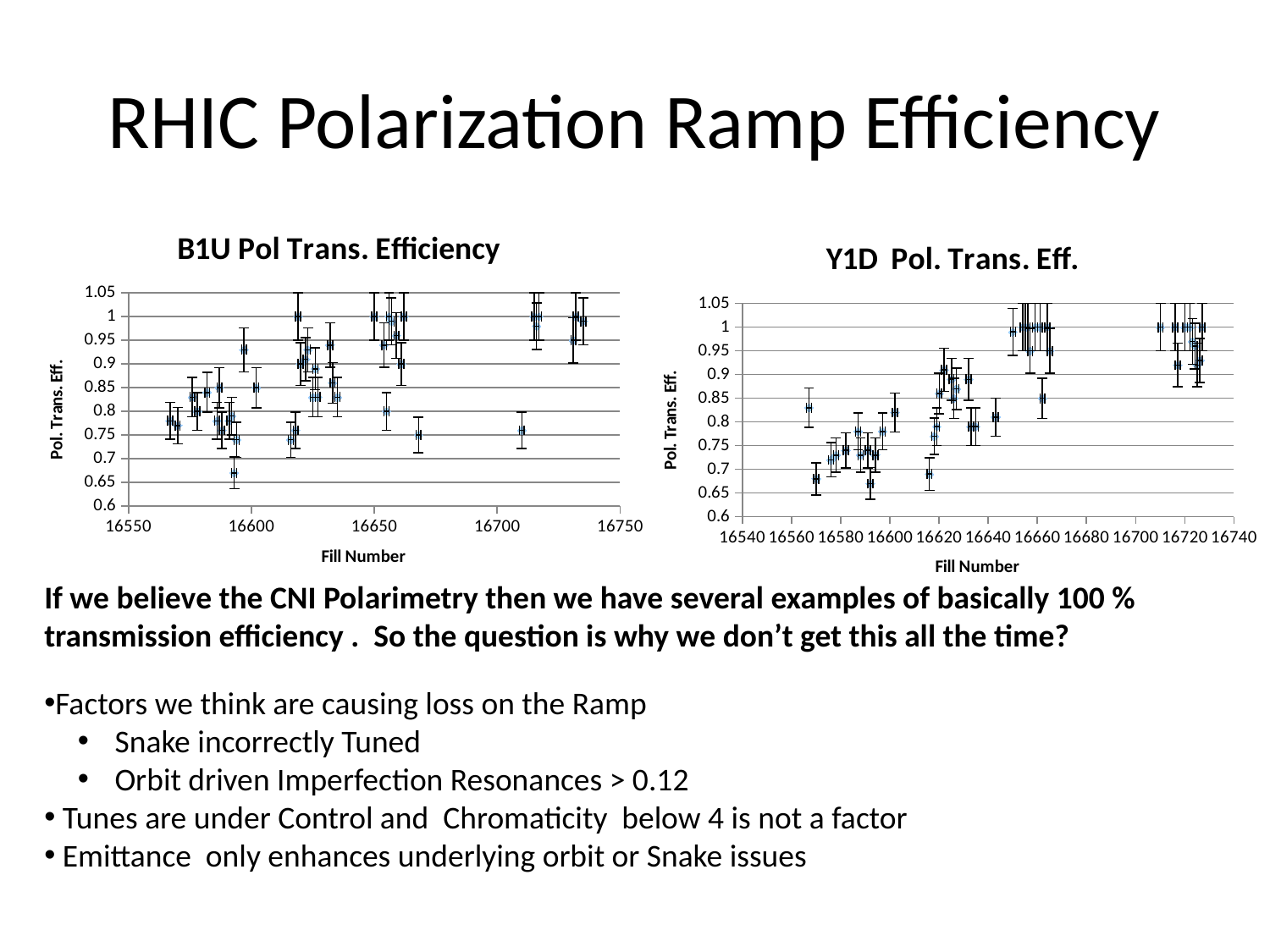
What kind of chart is the Y1D Pol. Trans. Eff. chart? scatter chart In the B1U Pol Trans. Efficiency chart, do the plotted values generally rise or fall as the fill number increases? rise What is the x-axis label of the Y1D Pol. Trans. Eff. chart? Fill Number In the Y1D Pol. Trans. Eff. chart, do the plotted values generally rise or fall as the fill number increases? rise What kind of chart is the B1U Pol Trans. Efficiency chart? scatter chart What is the title of the chart on the left of the slide? B1U Pol Trans. Efficiency In the B1U Pol Trans. Efficiency chart, is the value of the point near fill number 16710 greater or less than 0.8? less In the Y1D Pol. Trans. Eff. chart, is the lowest plotted value greater or less than 0.75? less In the B1U Pol Trans. Efficiency chart, is the lowest plotted value greater or less than 0.75? less